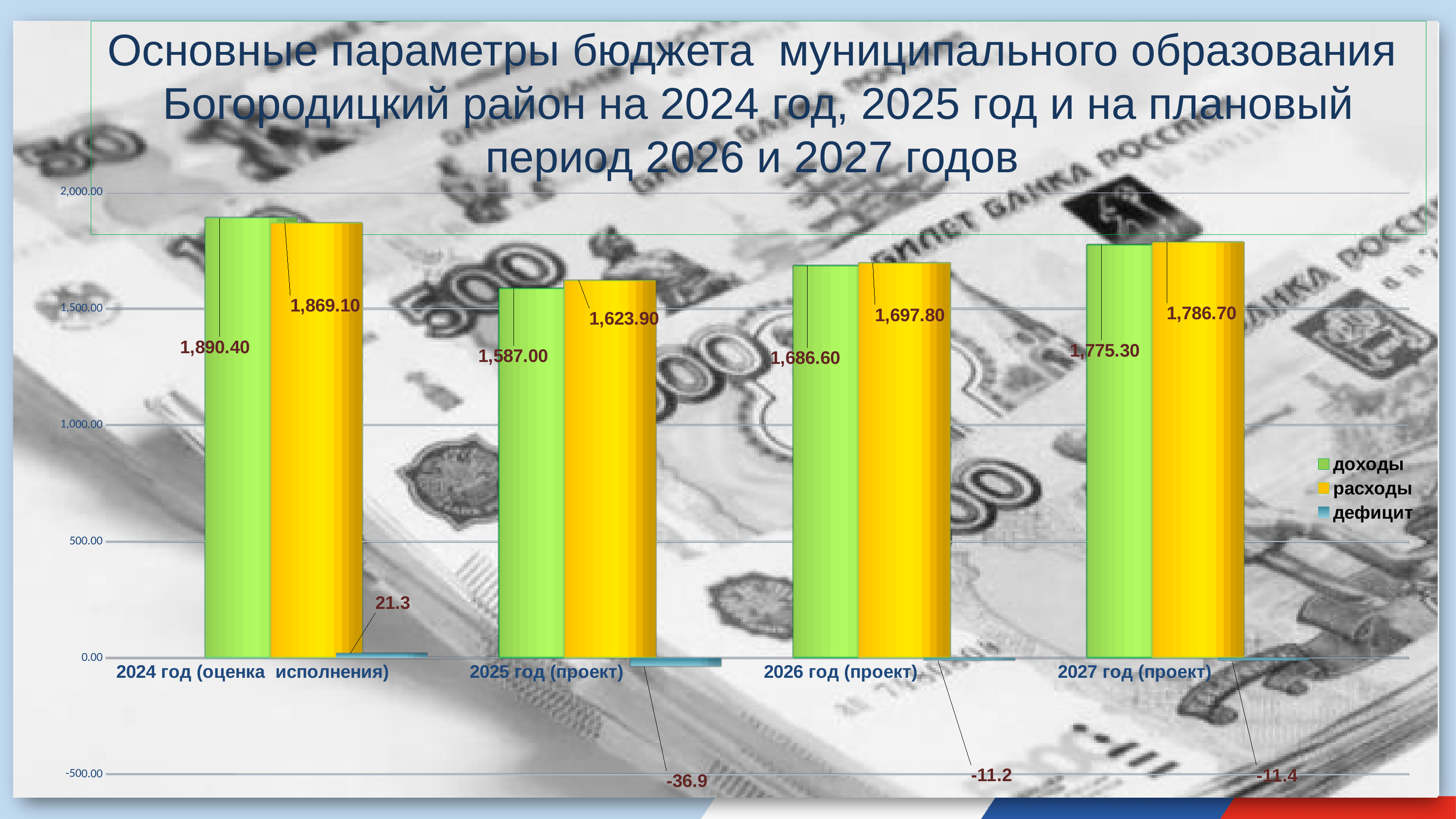
How many series does the legend list? 3 What is the value of дефицит for 2026 год (проект)? -11.2 What is the value of расходы for 2027 год (проект)? 1,786.70 What kind of chart is shown on the slide? bar chart What is the difference between расходы and доходы for 2026 год (проект)? 11.20 Is the value of доходы for 2025 год (проект) greater or less than 1,500.00? greater What is the value of расходы for 2025 год (проект)? 1,623.90 What is the value of доходы for 2024 год (оценка исполнения)? 1,890.40 How many categories are shown on the x axis? 4 Which category has the lowest value of расходы? 2025 год (проект) Which category has the highest value of доходы? 2024 год (оценка исполнения) Which is larger for 2025 год (проект): доходы or расходы? расходы